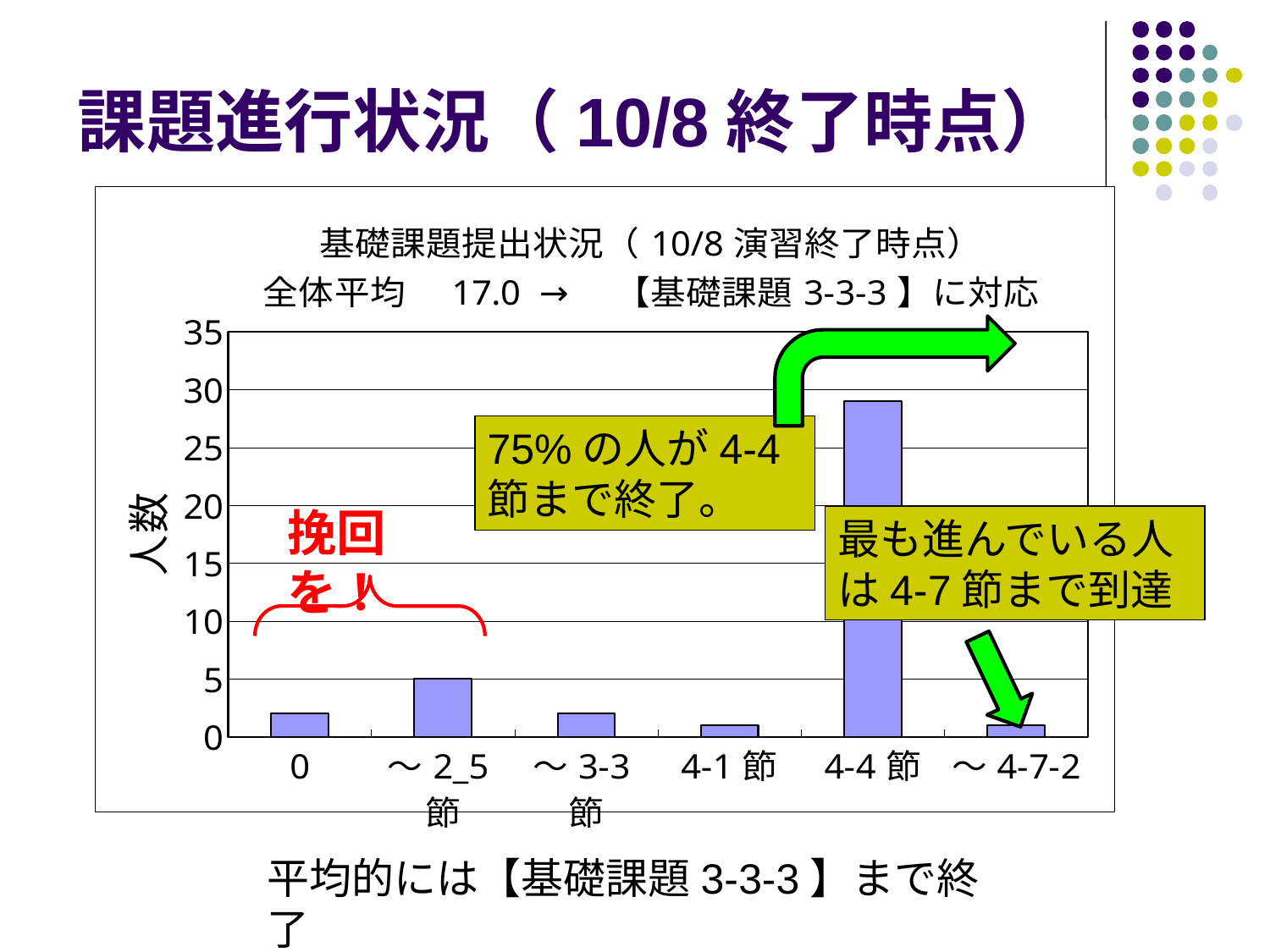
Which is larger, the value for 4-4 節 or the value for 0? 4-4 節 What overall average (全体平均) is stated in the chart title? 17.0 Which is larger, the value for ～2_5 節 or the value for 0? ～2_5 節 How many categories are shown on the x axis of the chart? 6 Is the value for 0 greater or less than 5? less Which category has the highest bar in the chart? 4-4 節 Is the value for 4-4 節 greater or less than 25? greater What is the label of the y axis of the chart? 人数 Is the value for 4-1 節 greater or less than 5? less What kind of chart is shown on the slide? bar chart